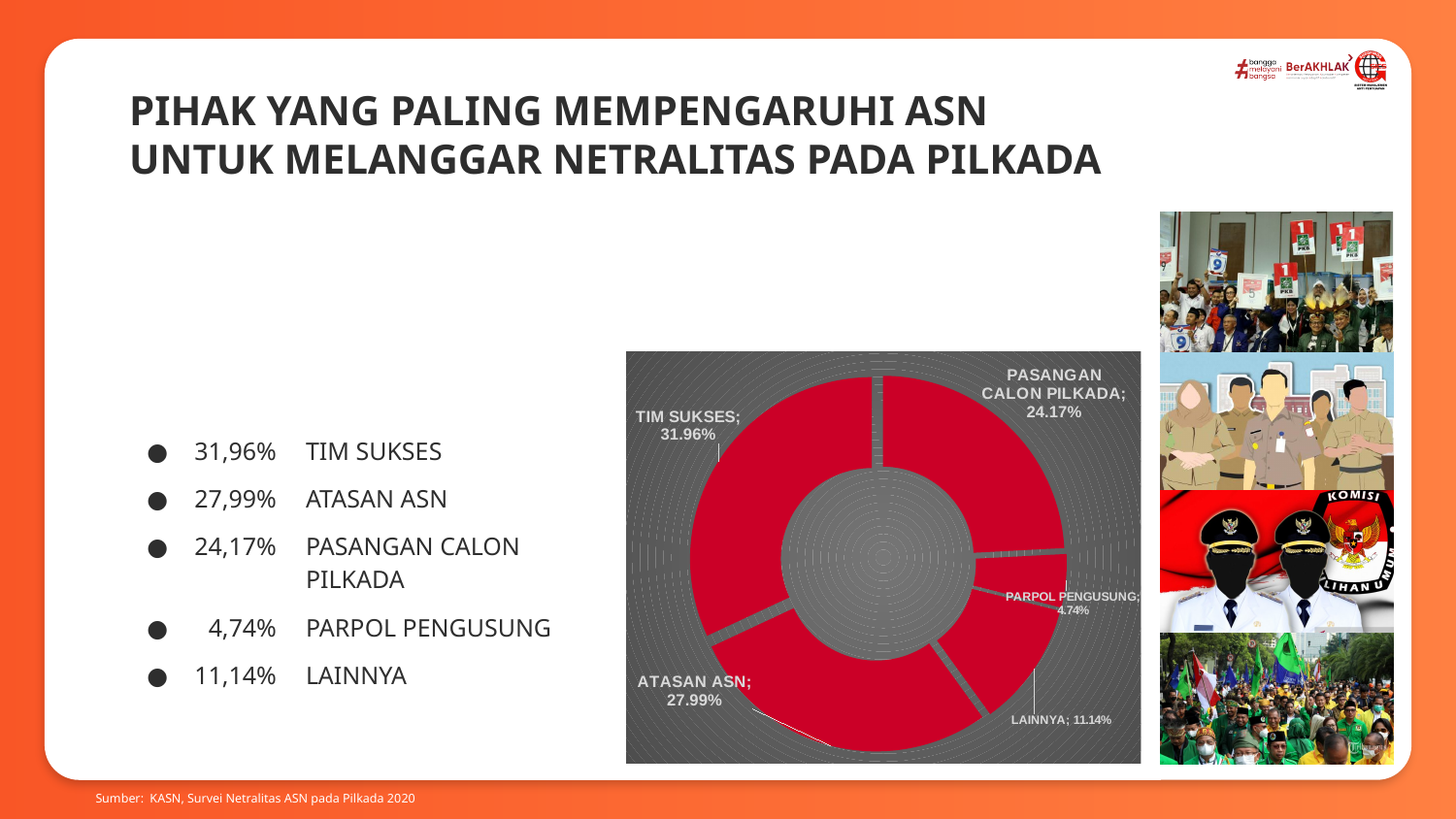
What is the difference in percentage points between LAINNYA and PARPOL PENGUSUNG? 6.4 How many categories are shown in the chart? 5 What percentage does the chart show for ATASAN ASN? 27.99% What percentage does the chart show for PARPOL PENGUSUNG? 4.74% What percentage does the chart show for PASANGAN CALON PILKADA? 24.17% Which is larger, the share for ATASAN ASN or the share for PASANGAN CALON PILKADA? ATASAN ASN What percentage does the chart show for LAINNYA? 11.14% What kind of chart is shown on the slide? Doughnut (pie) chart What is the difference in percentage points between TIM SUKSES and ATASAN ASN? 3.97 Which category has the smallest share in the chart? PARPOL PENGUSUNG What percentage does the chart show for TIM SUKSES? 31.96% Which category has the largest share in the chart? TIM SUKSES